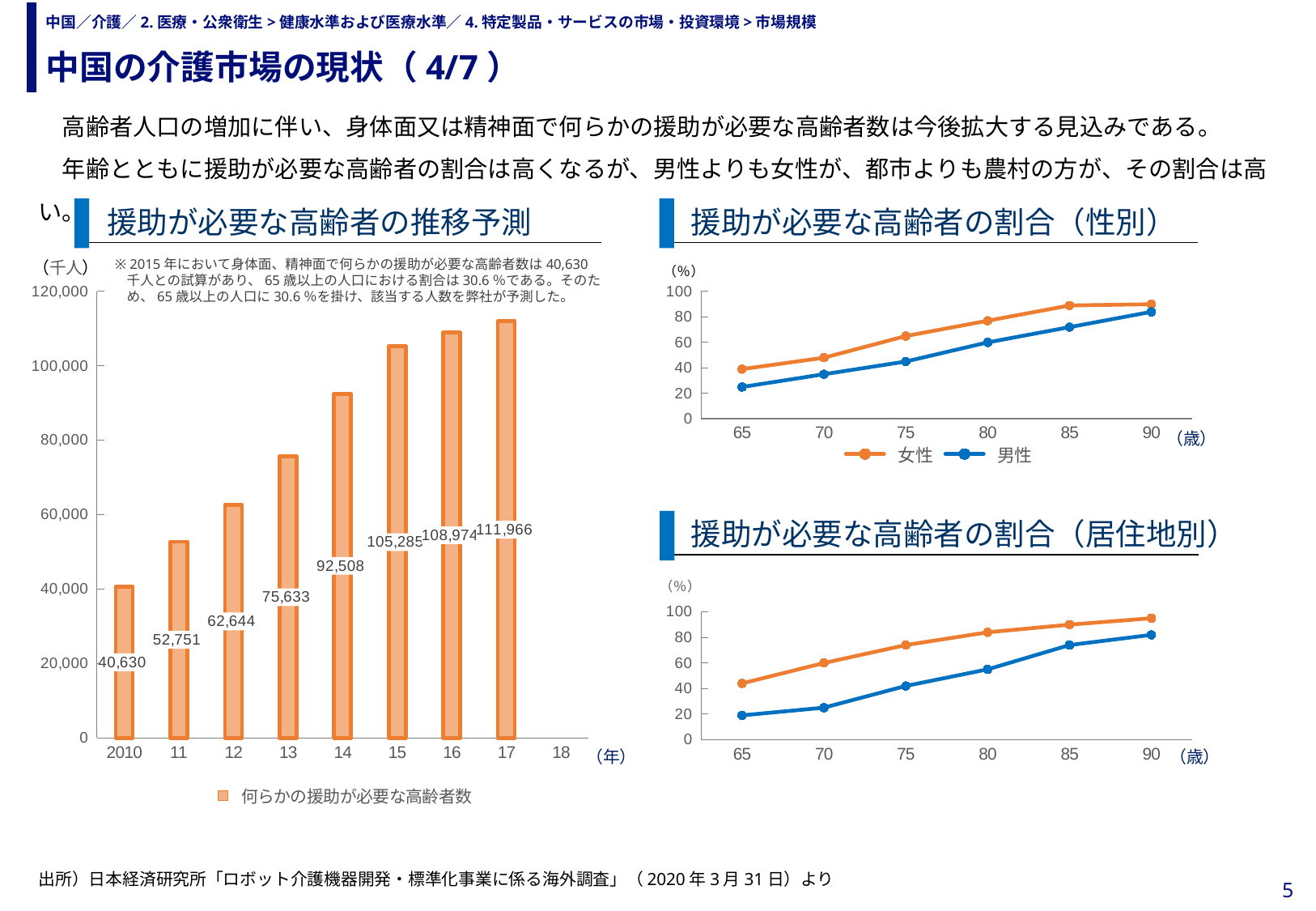
In the chart 「援助が必要な高齢者の割合（性別）」, is the value for 男性 at age 65 greater or less than 40? less In the chart 「援助が必要な高齢者の割合（性別）」, which series has the higher value at age 70, 女性 or 男性? 女性 In the chart 「援助が必要な高齢者の推移予測」, what is the value of the tallest bar? 111,966 What type of chart is 「援助が必要な高齢者の推移予測」 on the left of the slide? bar chart In the chart 「援助が必要な高齢者の割合（居住地別）」, is the value of the orange line at age 90 greater or less than 80? greater In the chart 「援助が必要な高齢者の推移予測」, what is the value of the shortest bar? 40,630 In the chart 「援助が必要な高齢者の推移予測」, how many bars are plotted? 8 In the chart 「援助が必要な高齢者の推移予測」, do the bar values rise or fall from left to right? rise In the chart 「援助が必要な高齢者の推移予測」, what is the legend entry for the bars? 何らかの援助が必要な高齢者数 In the chart 「援助が必要な高齢者の推移予測」, what is the difference between the tallest bar and the shortest bar? 71,336 In the chart 「援助が必要な高齢者の推移予測」, what is the difference between the bars labelled 105,285 and 92,508? 12,777 In the chart 「援助が必要な高齢者の割合（性別）」, how many series does the legend list? 2